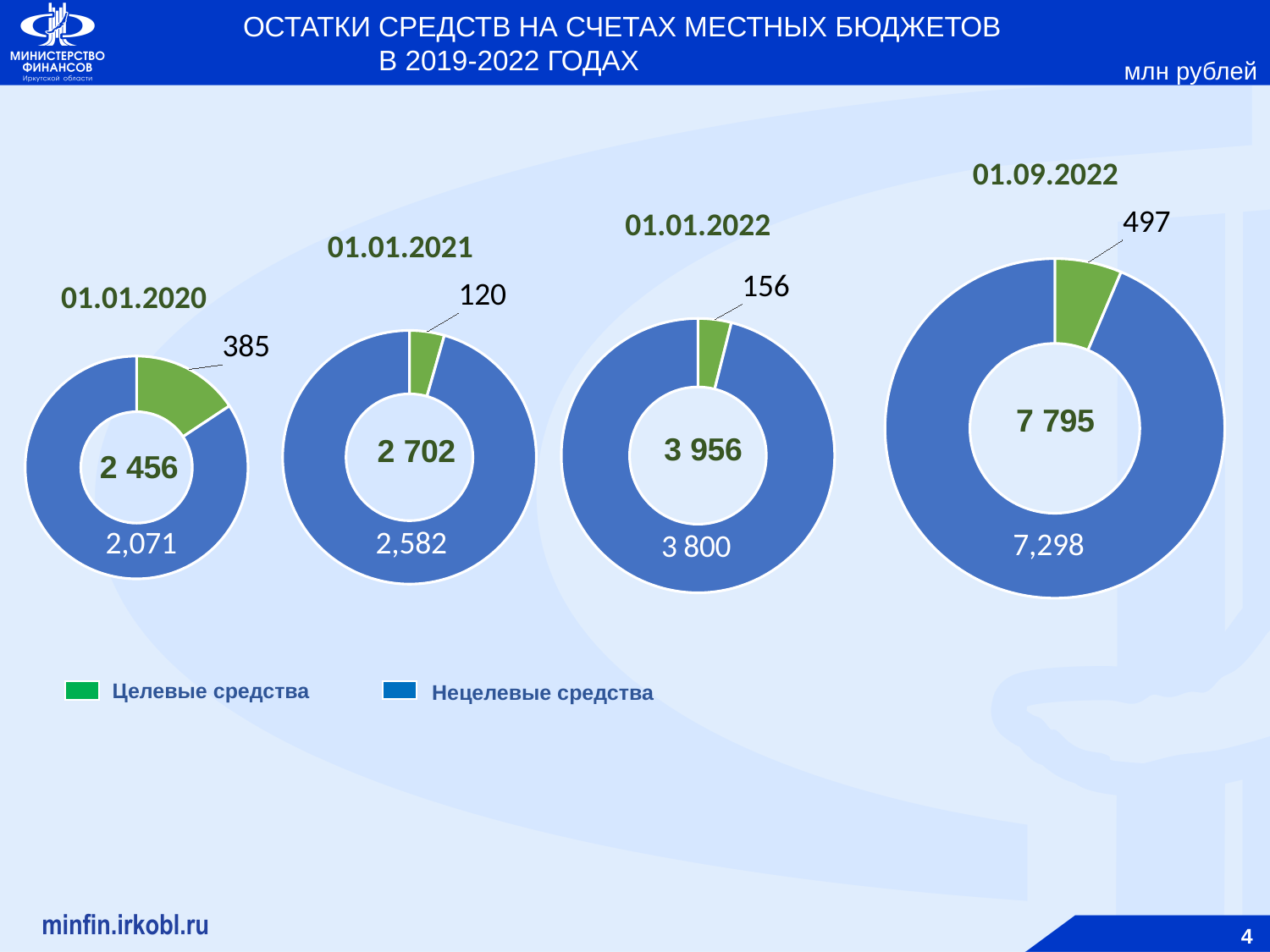
In the 01.01.2020 donut chart, which is larger: Целевые средства or Нецелевые средства? Нецелевые средства Across the four donut charts, which date has the smallest value for Целевые средства? 01.01.2021 What is the difference between the Целевые средства values in the 01.09.2022 and 01.01.2022 donut charts? 341 In the 01.09.2022 donut chart, what is the value for Нецелевые средства? 7,298 In the 01.01.2022 donut chart, what is the value for Целевые средства? 156 What kind of charts are shown on the slide? Donut (pie) charts Across the four donut charts, which date has the largest value for Целевые средства? 01.09.2022 In the 01.01.2020 donut chart, what is the value for Целевые средства? 385 What total is shown in the centre of the 01.01.2022 donut chart? 3 956 How many series does the legend list? 2 In the 01.01.2021 donut chart, what is the value for Нецелевые средства? 2,582 What total is shown in the centre of the 01.09.2022 donut chart? 7 795